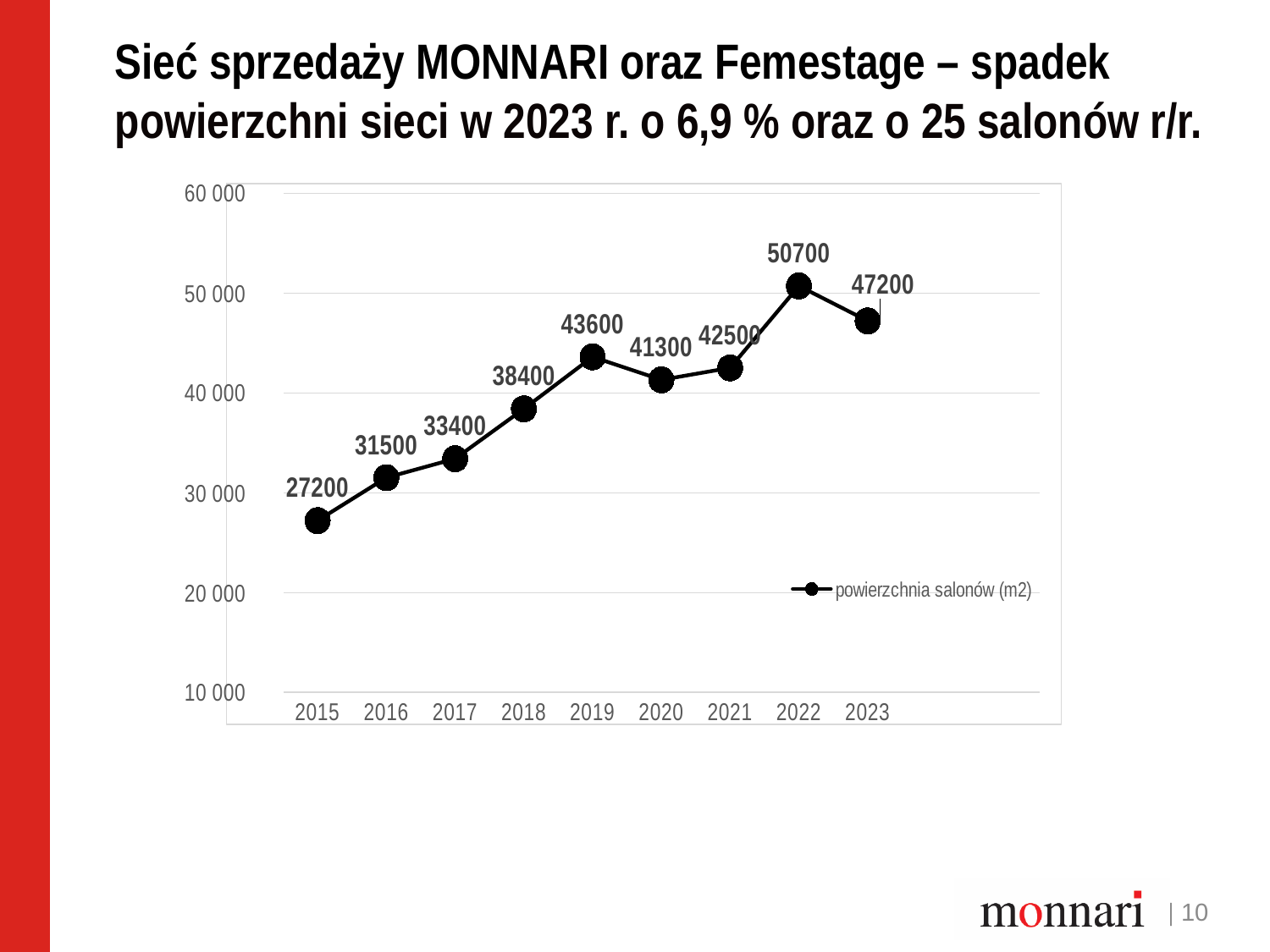
What is the value for 2023? 47200 What is the value for 2015? 27200 Is the value for 2018 greater or less than 40 000? less How many series does the legend list? 1 Which is larger, the value for 2020 or the value for 2021? 2021 What is the difference between the values for 2022 and 2023? 3500 What is the value for 2019? 43600 Which year has the highest value? 2022 Which year has the lowest value? 2015 How many years are plotted on the chart? 9 What is the name of the series shown in the legend? powierzchnia salonów (m2) What kind of chart is shown on the slide? line chart